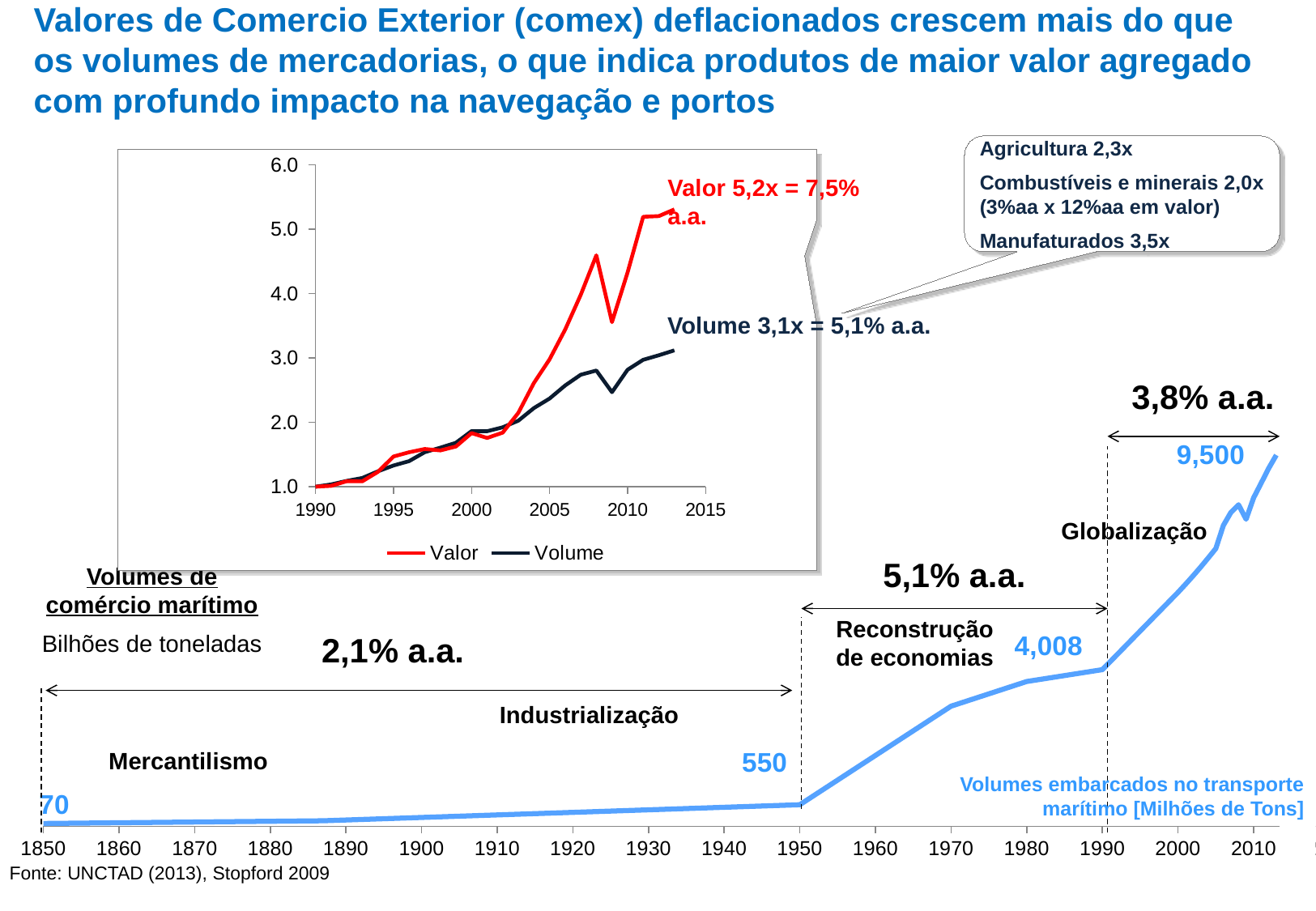
In the inset chart (Valor/Volume), is the value of the Valor series in 2013 greater or less than 4.0? greater How many series does the legend of the inset chart (Valor/Volume) list? 2 In the large chart of maritime trade volumes (1850–2010), what annual growth rate is shown for the Globalização period? 3,8% a.a. In the large chart of maritime trade volumes (1850–2010), what is the difference between the value labelled at 1990 and the value labelled at 1950? 3,458 In the large chart of maritime trade volumes (1850–2010), what is the lowest labelled value? 70 What kind of chart is the inset chart at the top of the slide (the one with the Valor and Volume series)? line chart In the large chart of maritime trade volumes (1850–2010), what value is labelled at 1990? 4,008 In the large chart of maritime trade volumes (1850–2010), what is the highest labelled value? 9,500 In the inset chart (Valor/Volume), do the two series generally rise or fall from 1990 to 2013? rise In the inset chart (Valor/Volume), is the value of the Volume series in 2013 greater or less than 4.0? less In the inset chart (Valor/Volume), which series is higher at the end of the period, around 2013? Valor In the large chart of maritime trade volumes (1850–2010), what value is labelled at 1950? 550